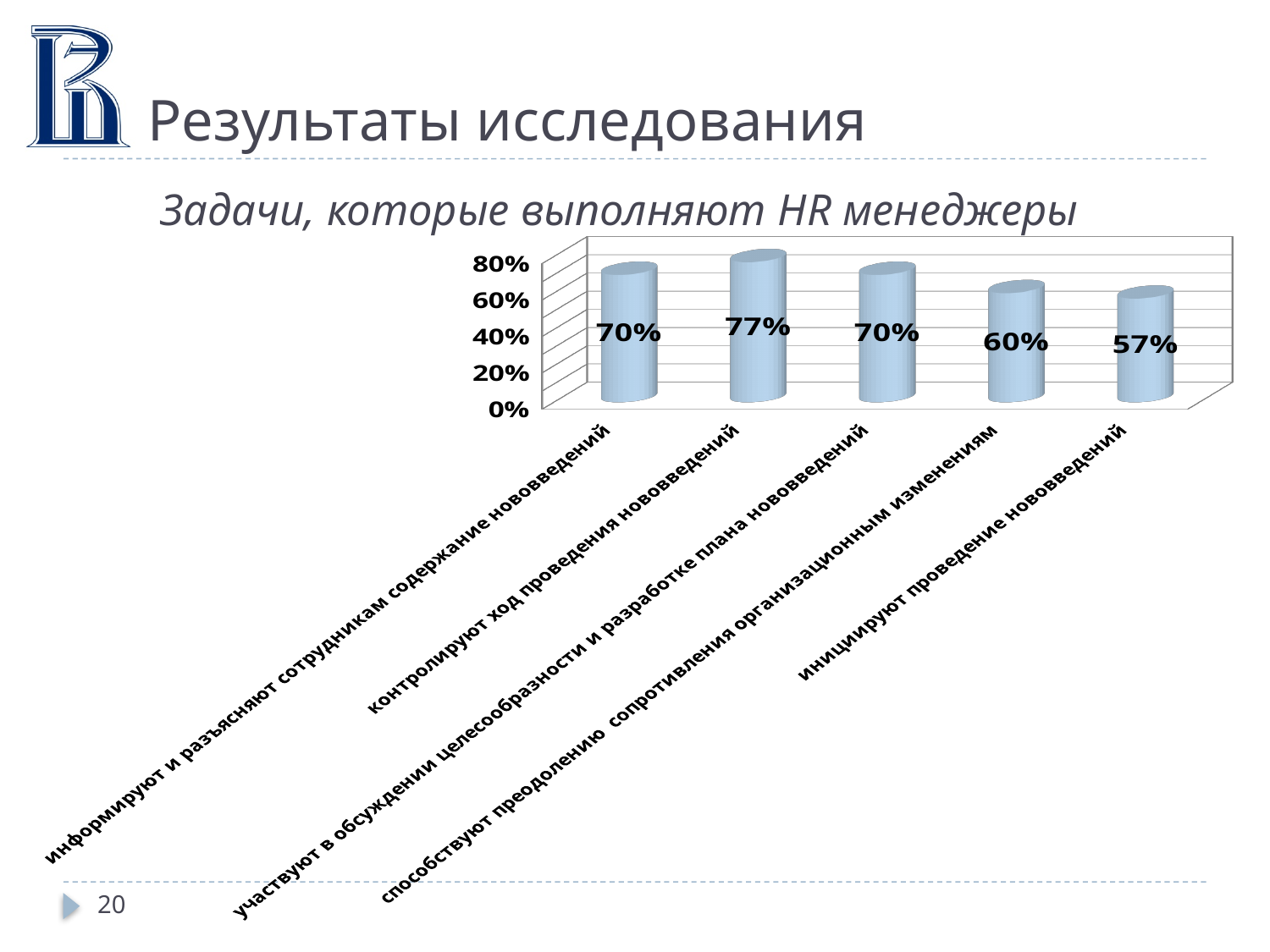
What value is shown for "информируют и разъясняют сотрудникам содержание нововведений"? 70% How many tasks (categories) are shown in the chart? 5 Which is larger: the value for "способствуют преодолению сопротивления организационным изменениям" or for "инициируют проведение нововведений"? способствуют преодолению сопротивления организационным изменениям Which task has the highest value? контролируют ход проведения нововведений What is the title of the chart? Задачи, которые выполняют HR менеджеры What value is shown for "контролируют ход проведения нововведений"? 77% What is the difference between the values for "контролируют ход проведения нововведений" and "инициируют проведение нововведений"? 20% What value is shown for "способствуют преодолению сопротивления организационным изменениям"? 60% What is the difference between the values for "участвуют в обсуждении целесообразности и разработке плана нововведений" and "способствуют преодолению сопротивления организационным изменениям"? 10% What kind of chart is shown on the slide? bar chart What value is shown for "инициируют проведение нововведений"? 57% Which task has the lowest value? инициируют проведение нововведений